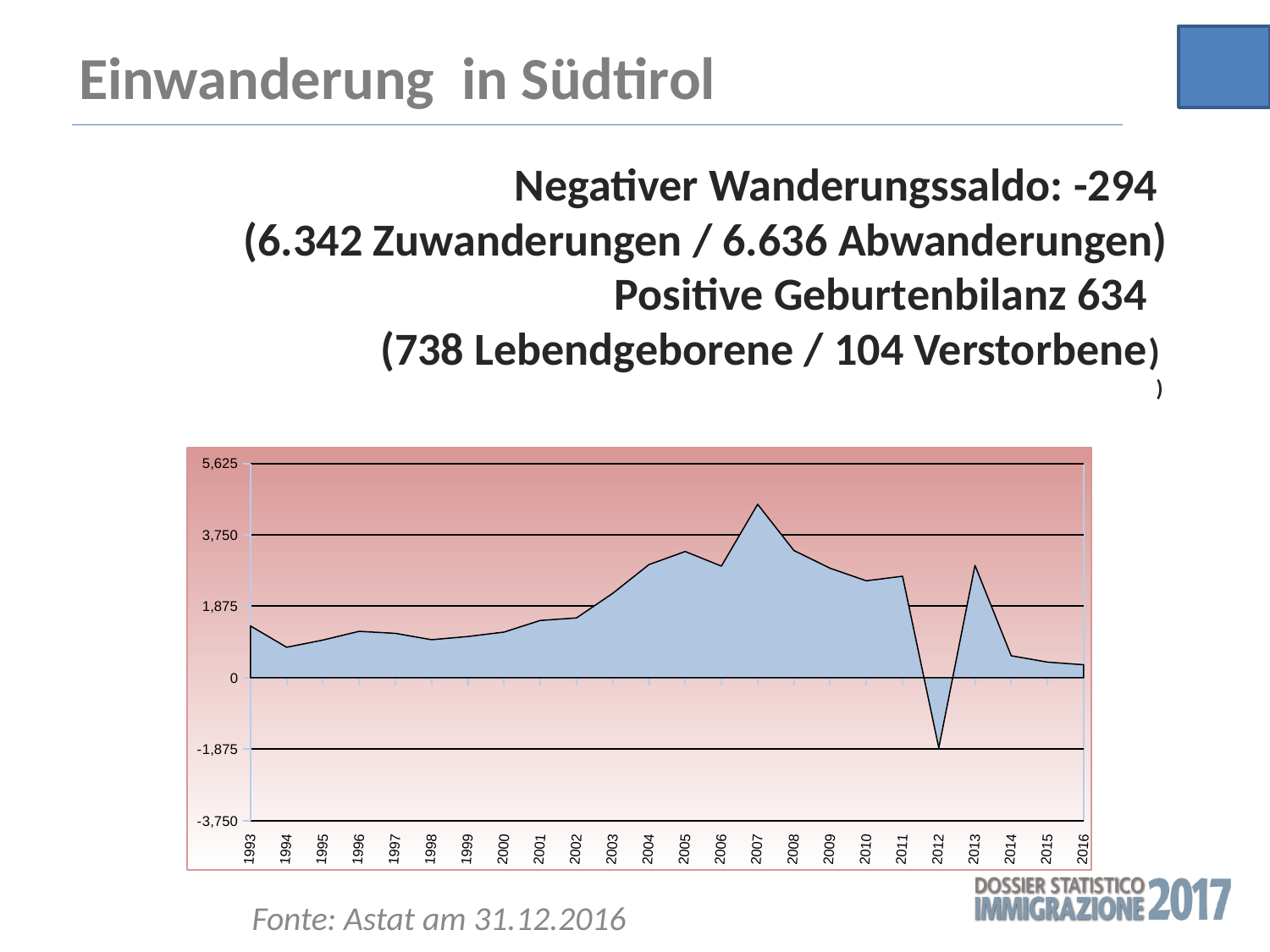
How many years are plotted on the x axis of the chart? 24 Is the value for 2007 greater or less than 3,750? greater Do the values rise or fall from 2013 to 2016? fall Is the value for 2004 greater or less than 1,875? greater Which year has the larger value, 2007 or 2005? 2007 Which year has the larger value, 2012 or 2013? 2013 Which year has the highest value in the chart? 2007 Which year has the lowest value in the chart? 2012 Is the value for 1994 greater or less than 1,875? less What kind of chart is shown on the slide? area chart